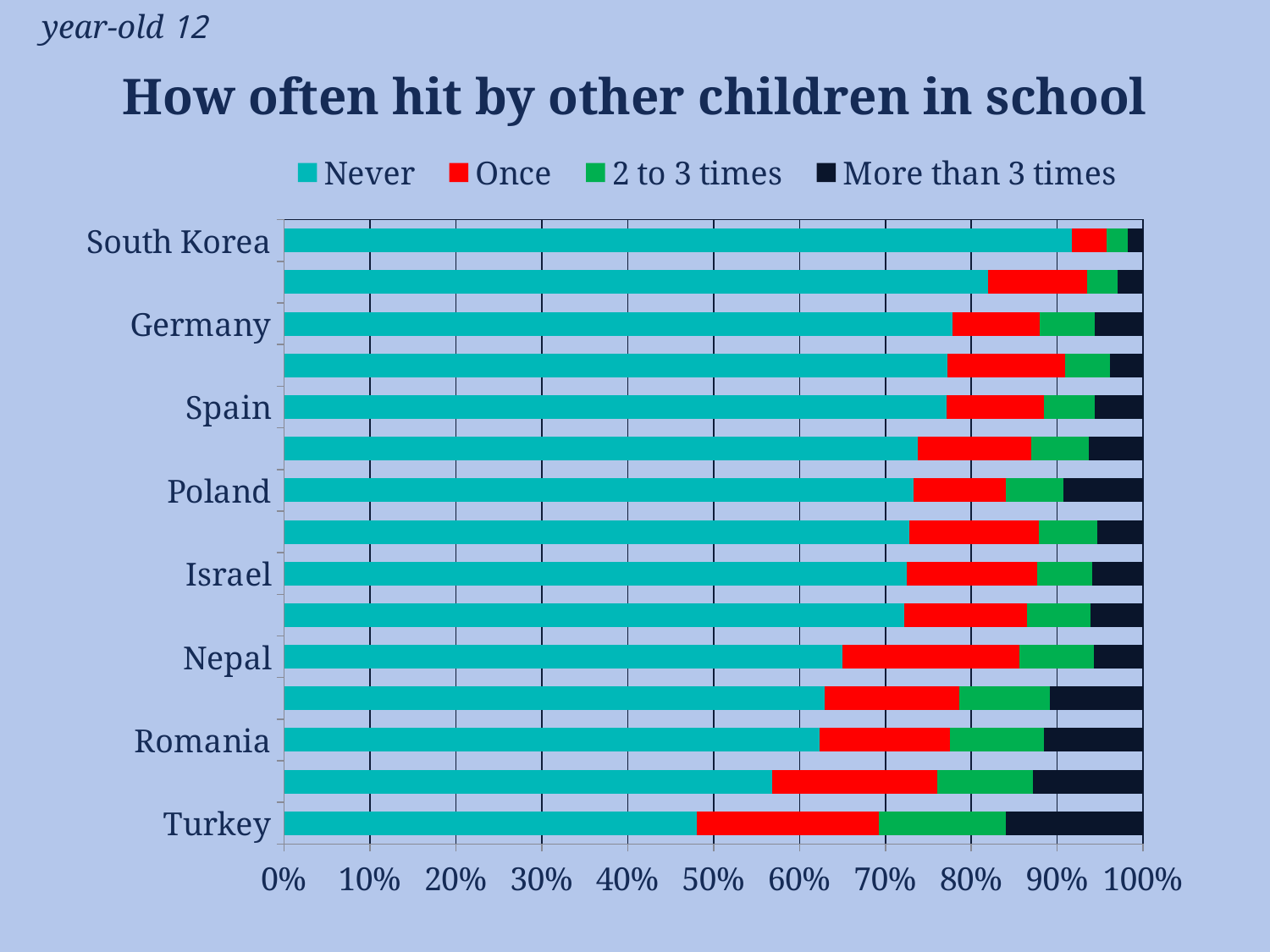
Is the 'Never' share for Turkey greater or less than 50%? less Which country has a larger 'Never' share, Germany or Nepal? Germany Which country has the lowest share of children who were never hit by other children in school? Turkey Is the 'Never' share for South Korea greater or less than 90%? greater Which country has the highest share of children who were never hit by other children in school? South Korea What is the title of the chart? How often hit by other children in school Is the 'Never' share for Nepal greater or less than 70%? less What kind of chart is shown on the slide? Stacked bar chart How many bars are plotted in the chart? 15 Which country has a larger 'Never' share, Turkey or Romania? Romania How many series does the legend list? 4